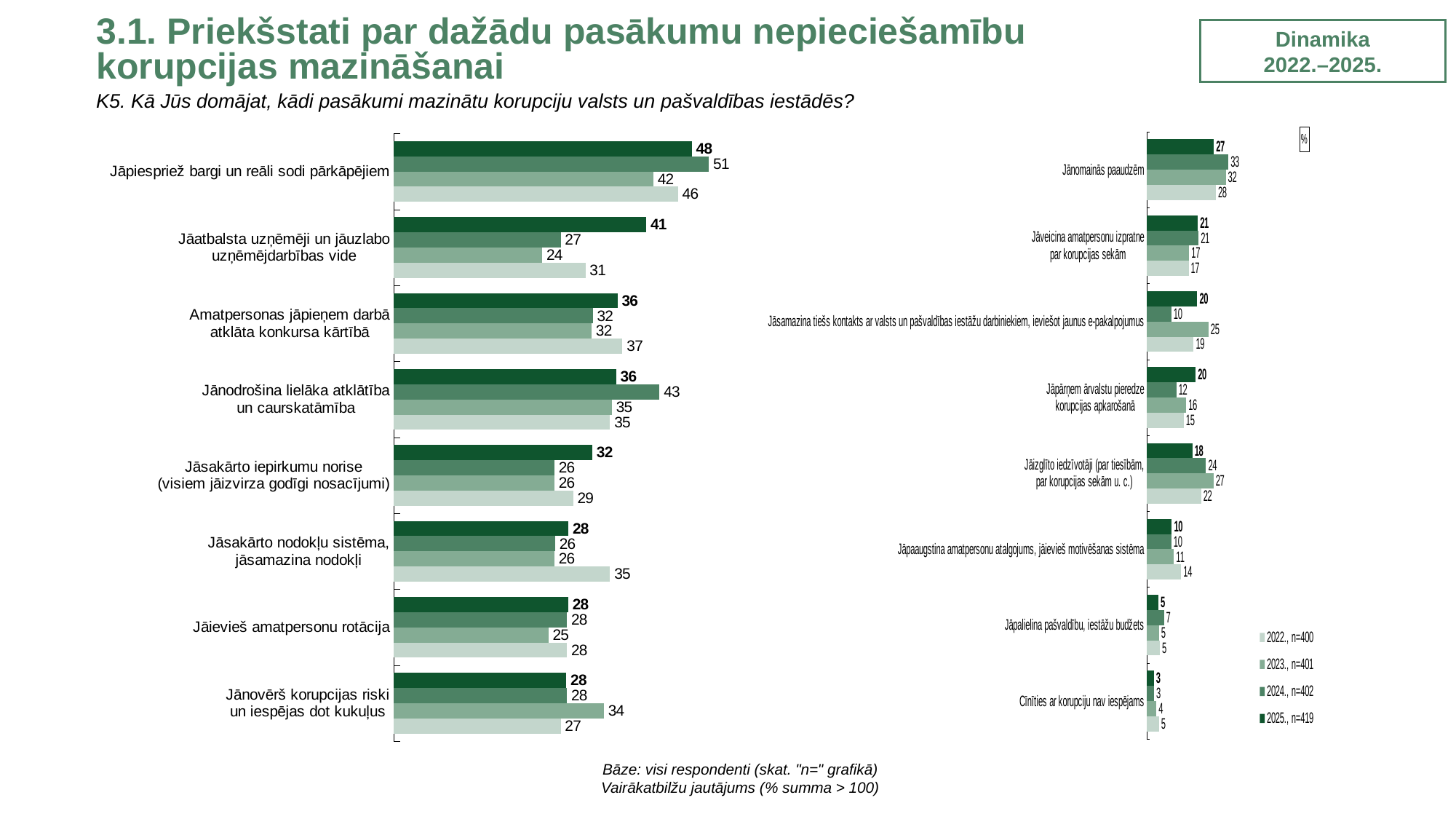
How many series does the legend list? 4 In the left chart, what is the 2022 value for "Jāsakārto nodokļu sistēma, jāsamazina nodokļi"? 35 How many categories are shown in the right chart? 8 What kind of chart is the left chart? Bar chart In the left chart, which category has the highest 2025 value? Jāpiespriež bargi un reāli sodi pārkāpējiem In the right chart, what is the difference between the 2024 and 2025 values for "Jānomainās paaudzēm"? 6 In the right chart, what is the 2023 value for "Jāsamazina tiešs kontakts ar valsts un pašvaldības iestāžu darbiniekiem, ieviešot jaunus e-pakalpojumus"? 25 In the right chart, which category has the lowest 2025 value? Cīnīties ar korupciju nav iespējams In the left chart, what is the difference between the 2025 and 2024 values for "Jāatbalsta uzņēmēji un jāuzlabo uzņēmējdarbības vide"? 14 In the left chart, for "Jānodrošina lielāka atklātība un caurskatāmība", which is larger: the 2024 value or the 2025 value? 2024 In the left chart, what is the 2025 value for "Jāpiespriež bargi un reāli sodi pārkāpējiem"? 48 According to the legend, what is the sample size (n) for 2025? n=419